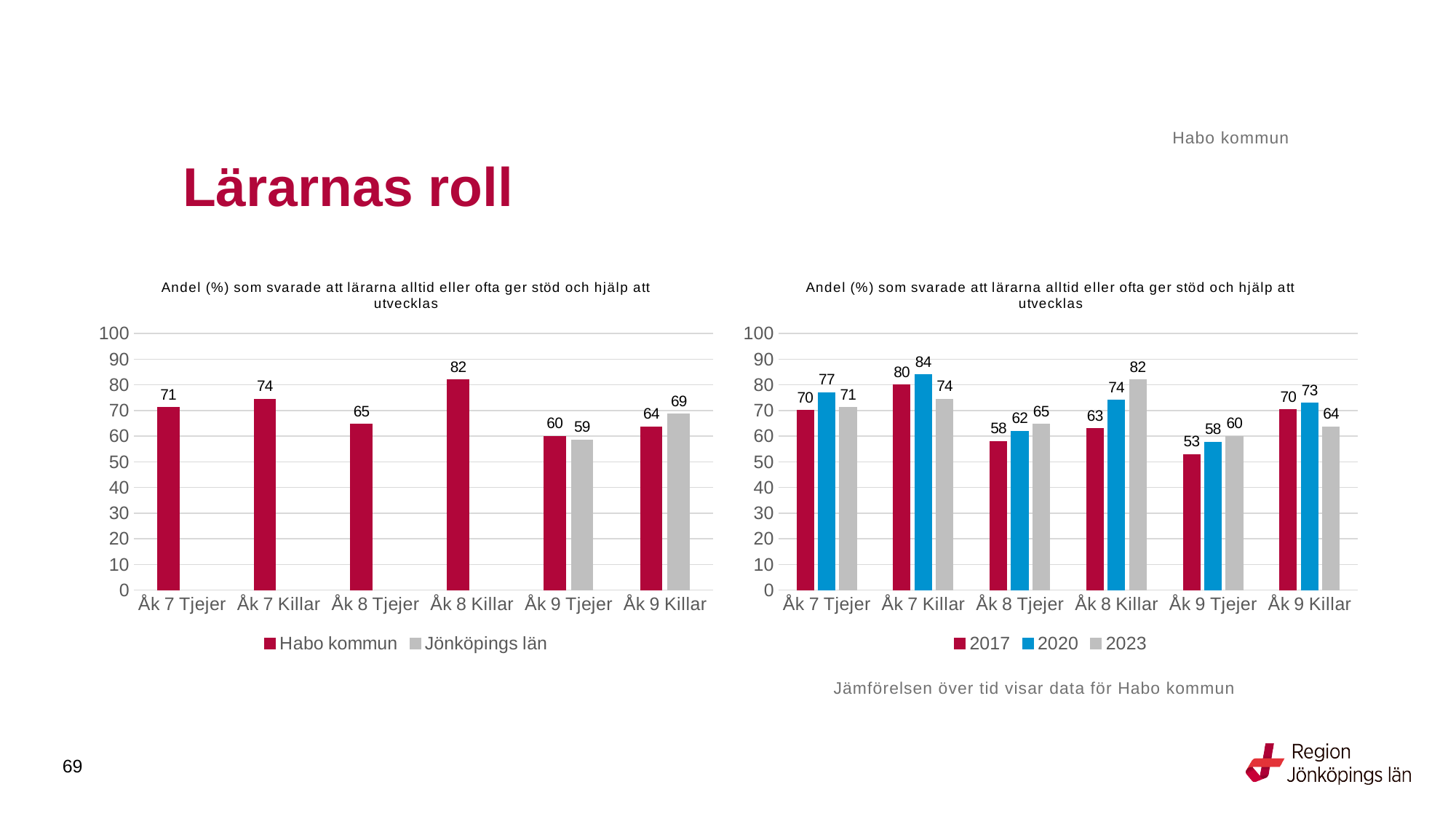
In the left chart, what is the value for Jönköpings län for Åk 9 Killar? 69 In the right chart, is the 2017 value for Åk 9 Killar larger or the 2023 value for Åk 9 Killar? 2017 In the left chart, how many series does the legend list? 2 In the left chart, which category has the highest Habo kommun value? Åk 8 Killar In the right chart, which category has the lowest 2017 value? Åk 9 Tjejer In the right chart, what is the difference between the 2023 and 2017 values for Åk 8 Killar? 19 In the right chart, what is the 2020 value for Åk 7 Killar? 84 In the left chart, what is the value for Habo kommun for Åk 8 Killar? 82 In the right chart, what is the 2023 value for Åk 8 Killar? 82 In the left chart, what is the difference between Habo kommun and Jönköpings län for Åk 9 Killar? 5 In the left chart, which category has the lowest Habo kommun value? Åk 9 Tjejer What type of chart is the right chart? Bar chart